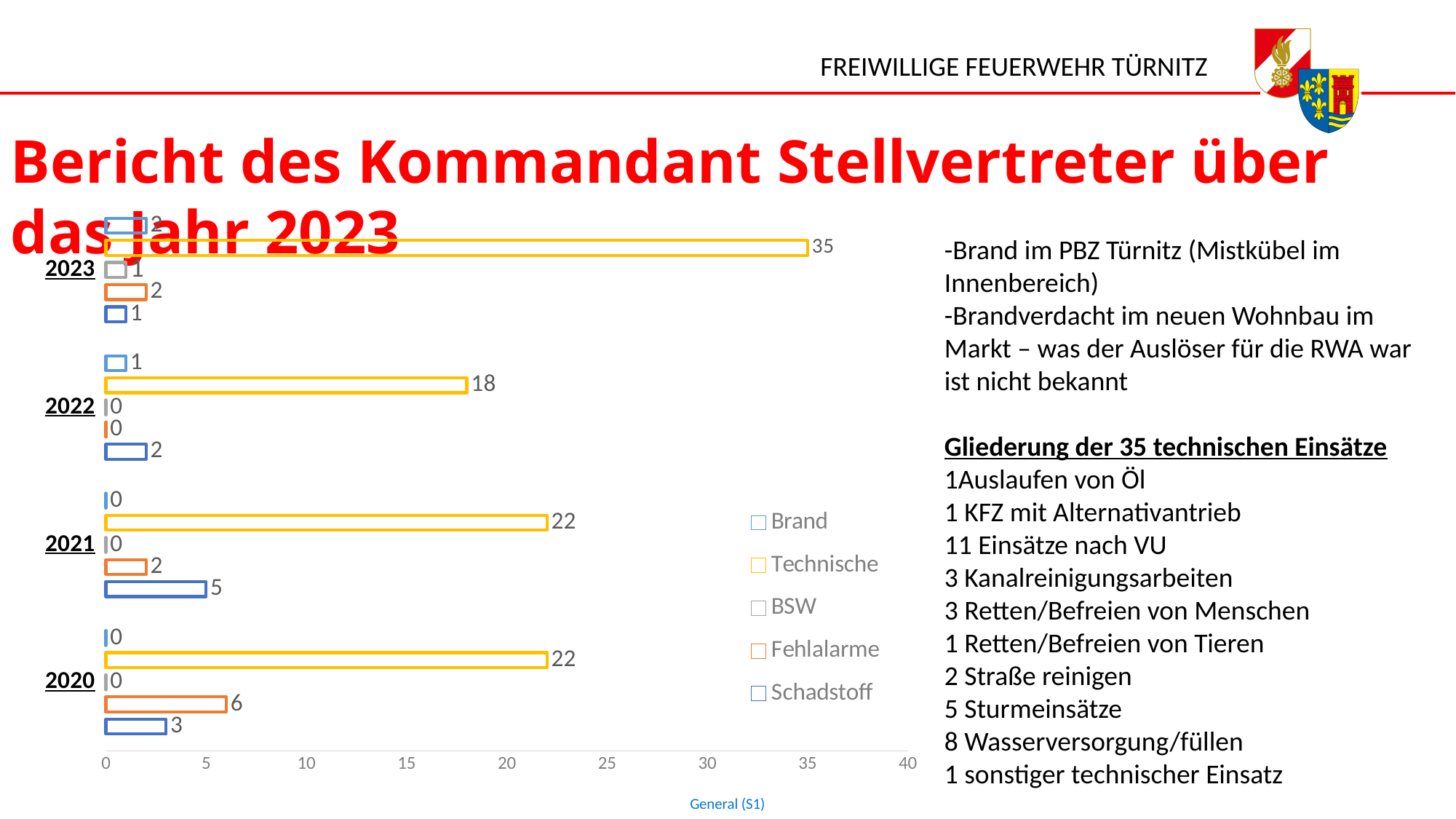
How many years (categories) are shown on the chart? 4 What is the value for Schadstoff in 2021? 5 Which series is shown in yellow in the legend? Technische What is the value for Fehlalarme in 2020? 6 In which year is the Technische value lowest? 2022 What is the value for Technische in 2023? 35 In which year is the Technische value highest? 2023 What kind of chart is shown on the slide? bar chart How many series does the chart legend list? 5 What is the value for Technische in 2022? 18 Which is larger, the Fehlalarme value for 2020 or for 2021? 2020 What is the difference between the Technische values for 2023 and 2022? 17